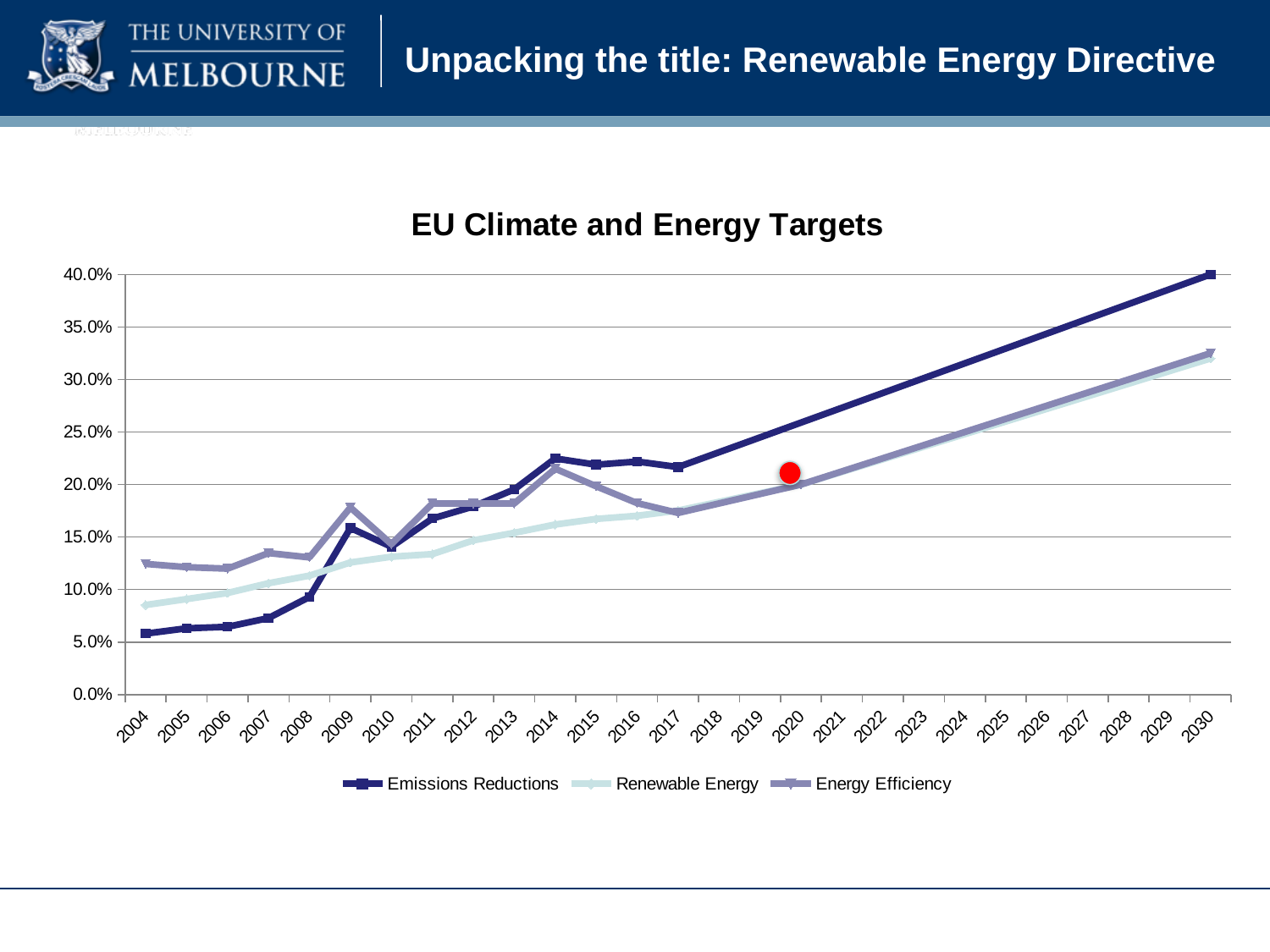
Which series has the highest value in 2030? Emissions Reductions Is the value for Renewable Energy in 2030 greater or less than 30.0%? greater Is the value for Energy Efficiency in 2009 greater or less than 15.0%? greater What type of chart is shown on the slide? line chart What is the title of the chart? EU Climate and Energy Targets Is the value for Emissions Reductions in 2004 greater or less than 10.0%? less How many years are shown along the x axis? 27 Which series has the lowest value in 2004? Emissions Reductions How many series does the legend list? 3 In 2004, which is larger: Energy Efficiency or Emissions Reductions? Energy Efficiency What is the value for Emissions Reductions in 2030? 40.0% Does the Emissions Reductions series rise or fall overall from 2004 to 2030? rise